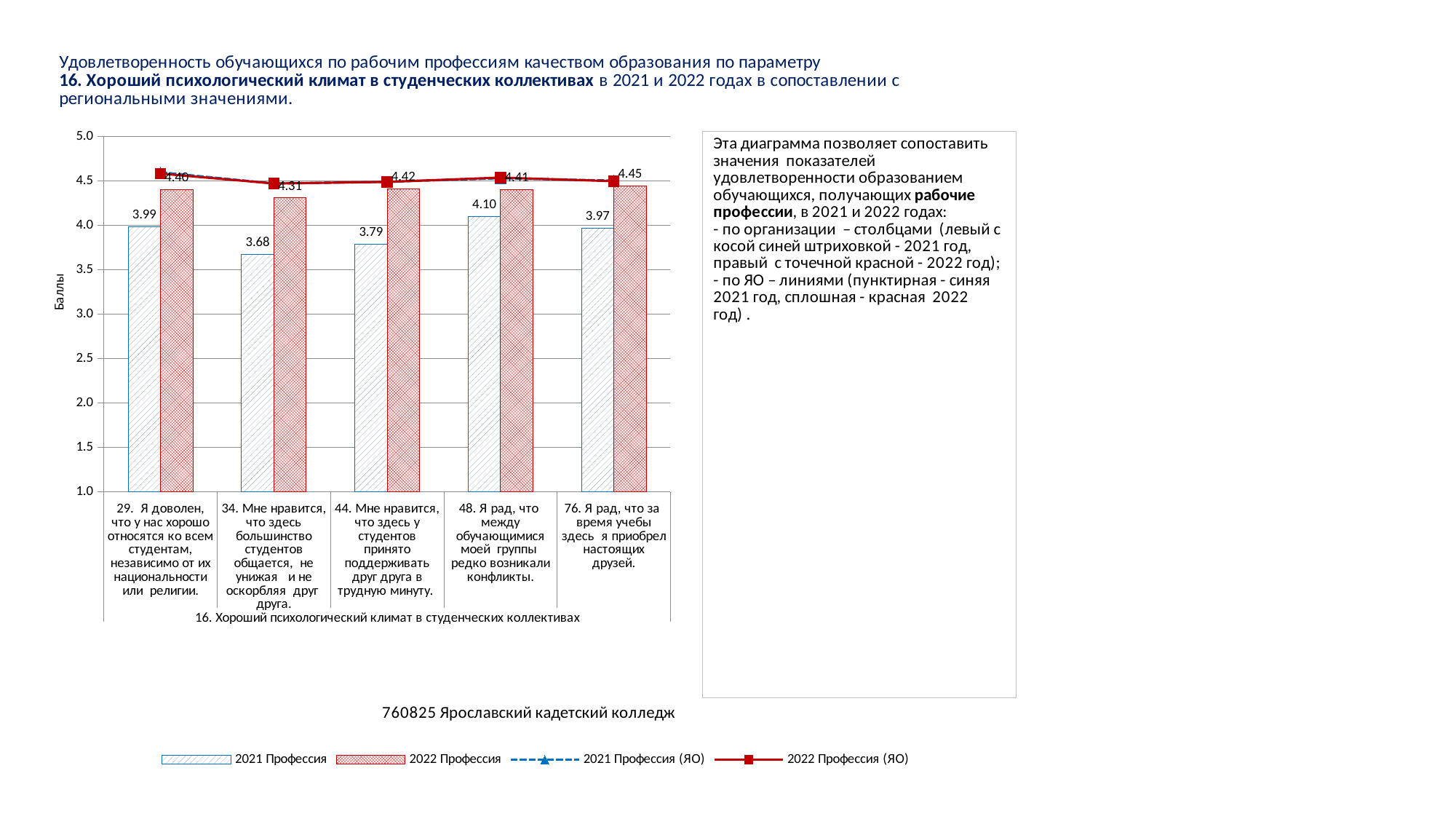
Which question has the highest 2022 Профессия value? 76. Я рад, что за время учебы здесь я приобрел настоящих друзей. Is the 2022 Профессия (ЯО) line value for question 29 greater or less than 4.5? greater What is the 2022 Профессия value for question 34 (Мне нравится, что здесь большинство студентов общается, не унижая и не оскорбляя друг друга)? 4.31 What is the 2022 Профессия value for question 76 (Я рад, что за время учебы здесь я приобрел настоящих друзей)? 4.45 What is the difference between the 2022 and 2021 Профессия values for question 44 (Мне нравится, что здесь у студентов принято поддерживать друг друга в трудную минуту)? 0.63 What is the label of the vertical axis of the chart? Баллы Which question has the highest 2021 Профессия value? 48. Я рад, что между обучающимися моей группы редко возникали конфликты. Which is larger for question 48: the 2021 Профессия value or the 2022 Профессия value? 2022 Профессия How many questions (categories) are shown on the x axis of the chart? 5 Which question has the lowest 2021 Профессия value? 34. Мне нравится, что здесь большинство студентов общается, не унижая и не оскорбляя друг друга. How many series does the chart legend list? 4 What is the 2021 Профессия value for question 29 (Я доволен, что у нас хорошо относятся ко всем студентам)? 3.99